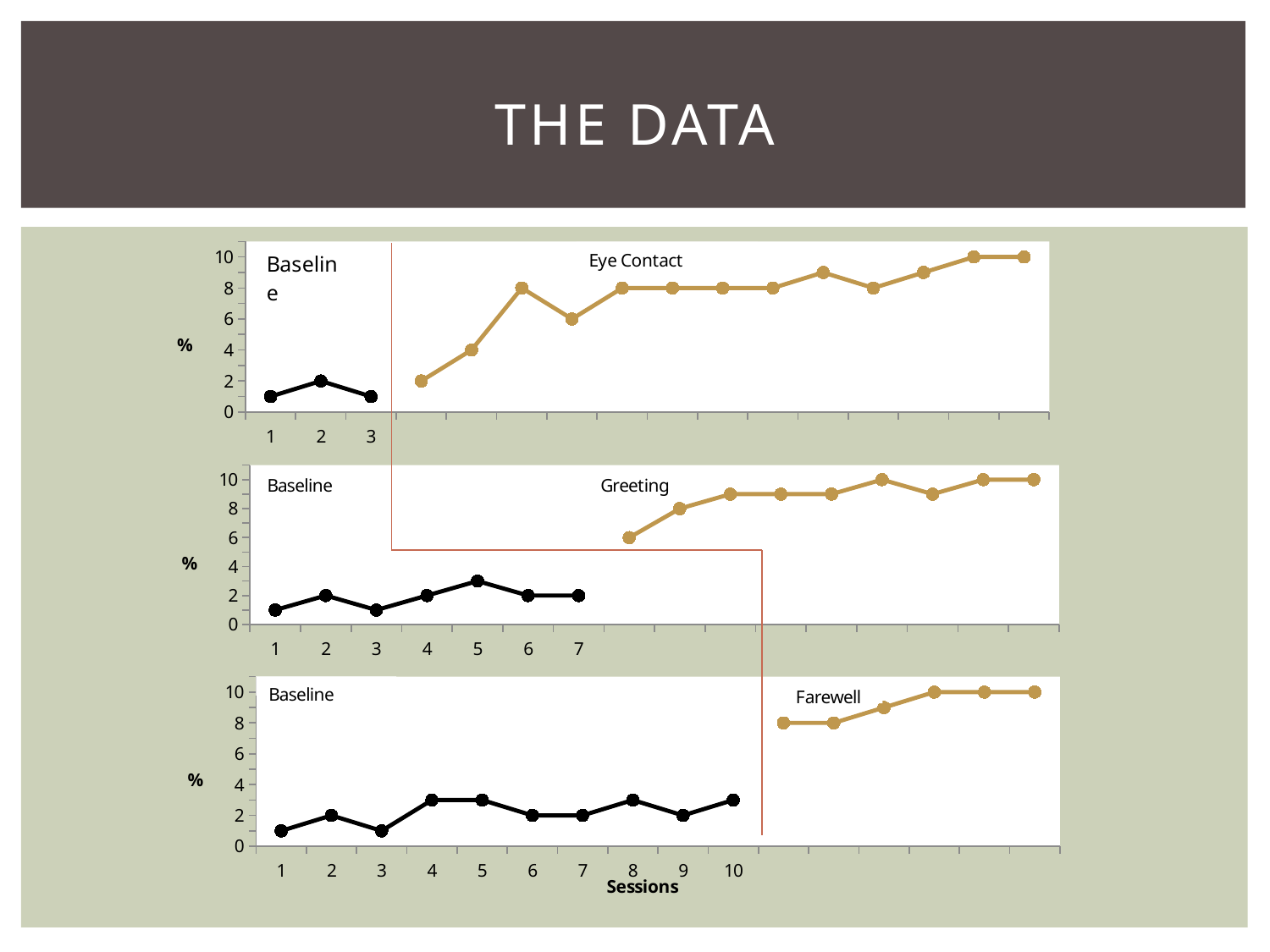
In the middle chart (Greeting), what is the baseline value at session 4? 2 In the bottom chart, is the first point of the Farewell phase greater or less than 6? greater What kind of chart is used on this slide? line chart In the middle chart (Greeting), how many baseline sessions are labelled on the x axis? 7 In the bottom chart, which baseline session has the larger value, session 3 or session 4? session 4 In the bottom chart (Farewell), what is the baseline value at session 2? 2 In the bottom chart (Farewell), how many baseline sessions are labelled on the x axis? 10 In the top chart (Eye Contact), what is the baseline value at session 2? 2 In the top chart, do the Eye Contact phase values generally rise or fall across sessions? rise In the middle chart, what is the difference between the last point of the Greeting phase and the first point of the Greeting phase? 4 In the top chart, is the first point of the Eye Contact phase greater or less than 4? less What is the x-axis label shown under the bottom chart? Sessions